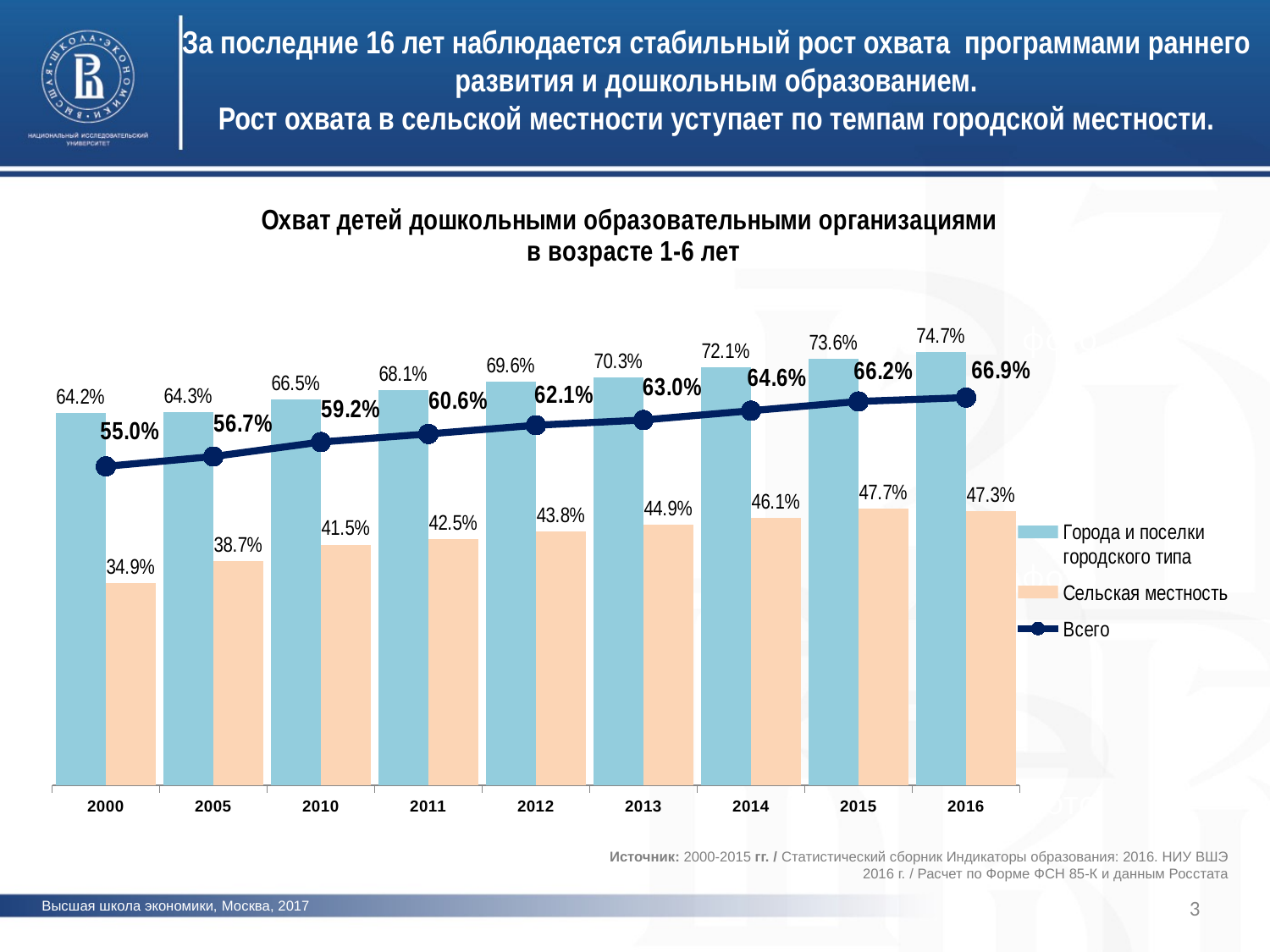
What kind of chart is this? Combined bar and line chart What is the difference between the 'Города и поселки городского типа' and 'Сельская местность' values in 2016? 27.4% In which year is the 'Сельская местность' value highest? 2015 How many series does the legend list? 3 What is the value of the 'Всего' line in 2012? 62.1% Which is larger: the 'Сельская местность' value in 2015 or in 2016? 2015 What is the value for 'Города и поселки городского типа' in 2016? 74.7% Does the 'Всего' line rise or fall from 2000 to 2016? Rises What is the title of the chart? Охват детей дошкольными образовательными организациями в возрасте 1-6 лет In which year is the 'Всего' value lowest? 2000 How many years are shown on the x axis? 9 What is the value for 'Сельская местность' in 2000? 34.9%